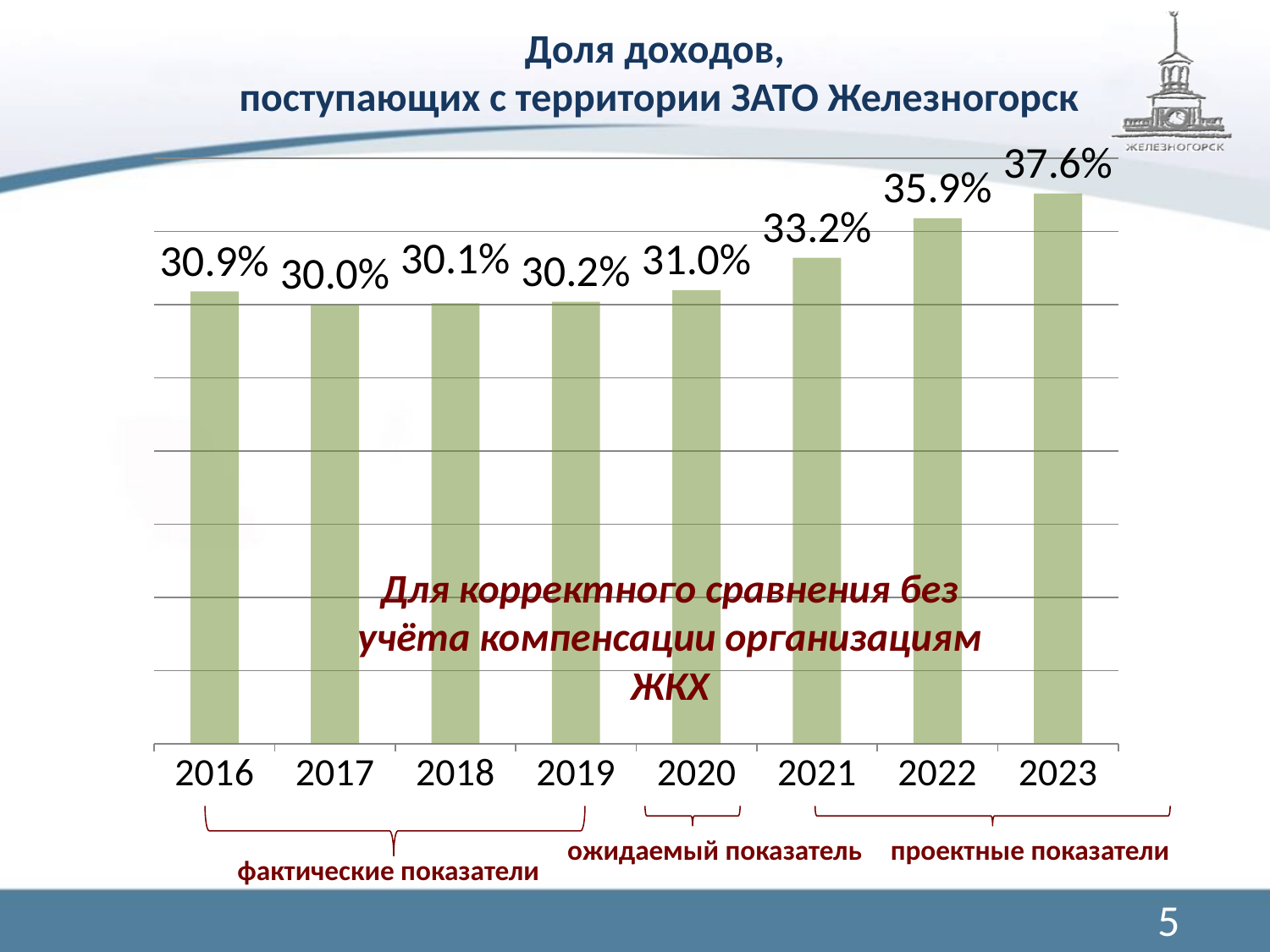
How many years are shown on the x axis? 8 What kind of chart is shown on the slide? bar chart Which is larger, the value for 2021 or the value for 2019? 2021 What is the difference between the values for 2022 and 2021? 2.7% Which year has the highest value? 2023 What is the value for 2016? 30.9% What is the value for 2020? 31.0% Do the values generally rise or fall from 2019 to 2023? rise What is the difference between the values for 2023 and 2016? 6.7% Which year has the lowest value? 2017 What is the title of the chart? Доля доходов, поступающих с территории ЗАТО Железногорск What is the value for 2023? 37.6%